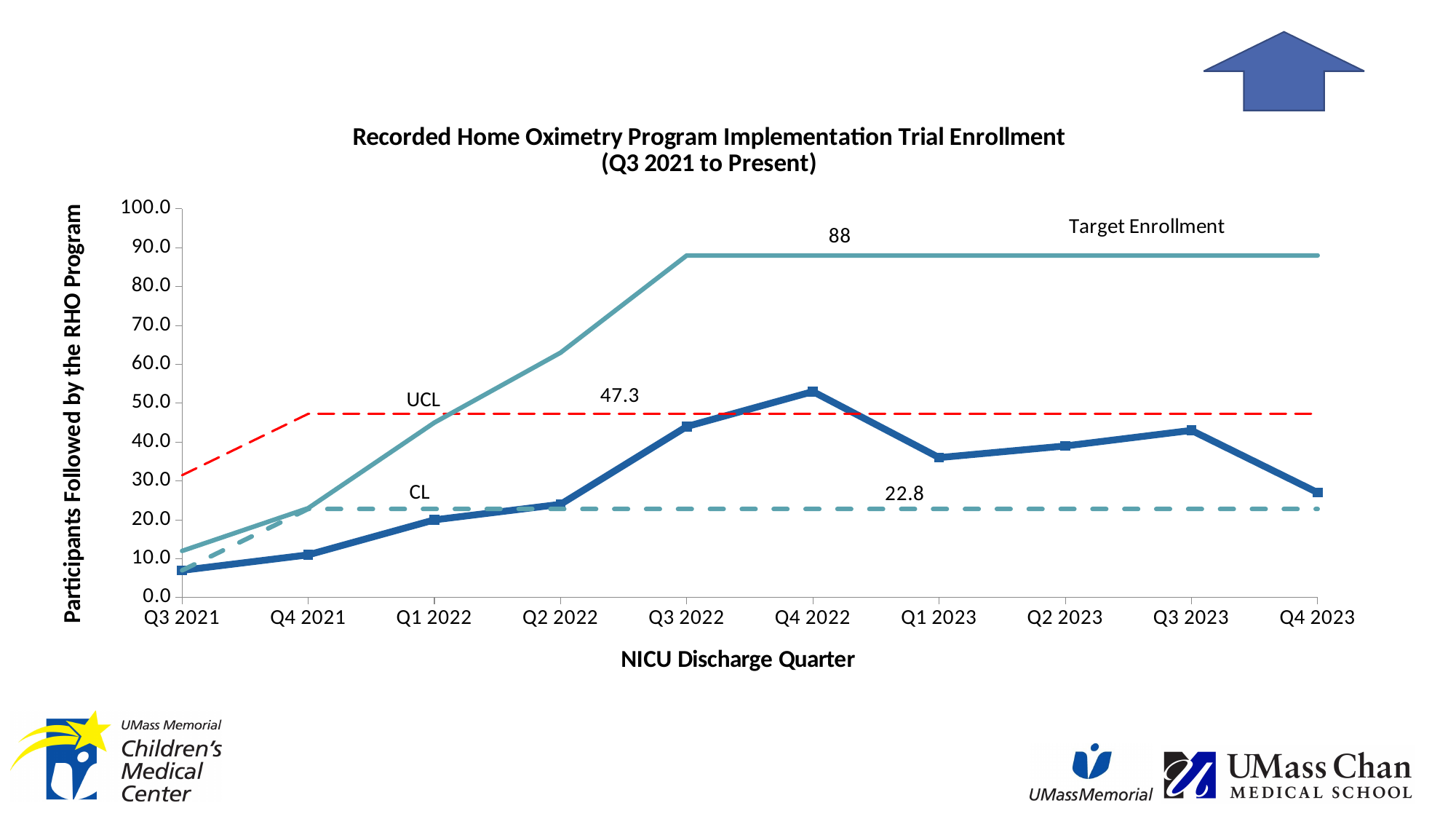
What is the value of the UCL line? 47.3 What is the title of the x axis? NICU Discharge Quarter Which quarter has more participants followed, Q1 2023 or Q3 2023? Q3 2023 In which quarter is the participants line at its lowest point? Q3 2021 What value does the Target Enrollment line reach at its plateau? 88 What is the difference between the Target Enrollment plateau value and the UCL value? 40.7 What is the difference between the UCL value and the CL value? 24.5 Is the number of participants in Q4 2022 greater or less than 50? greater What kind of chart is shown on the slide? line chart What is the value of the CL line? 22.8 How many NICU discharge quarters are plotted along the x axis? 10 In which quarter does the participants line reach its highest point? Q4 2022